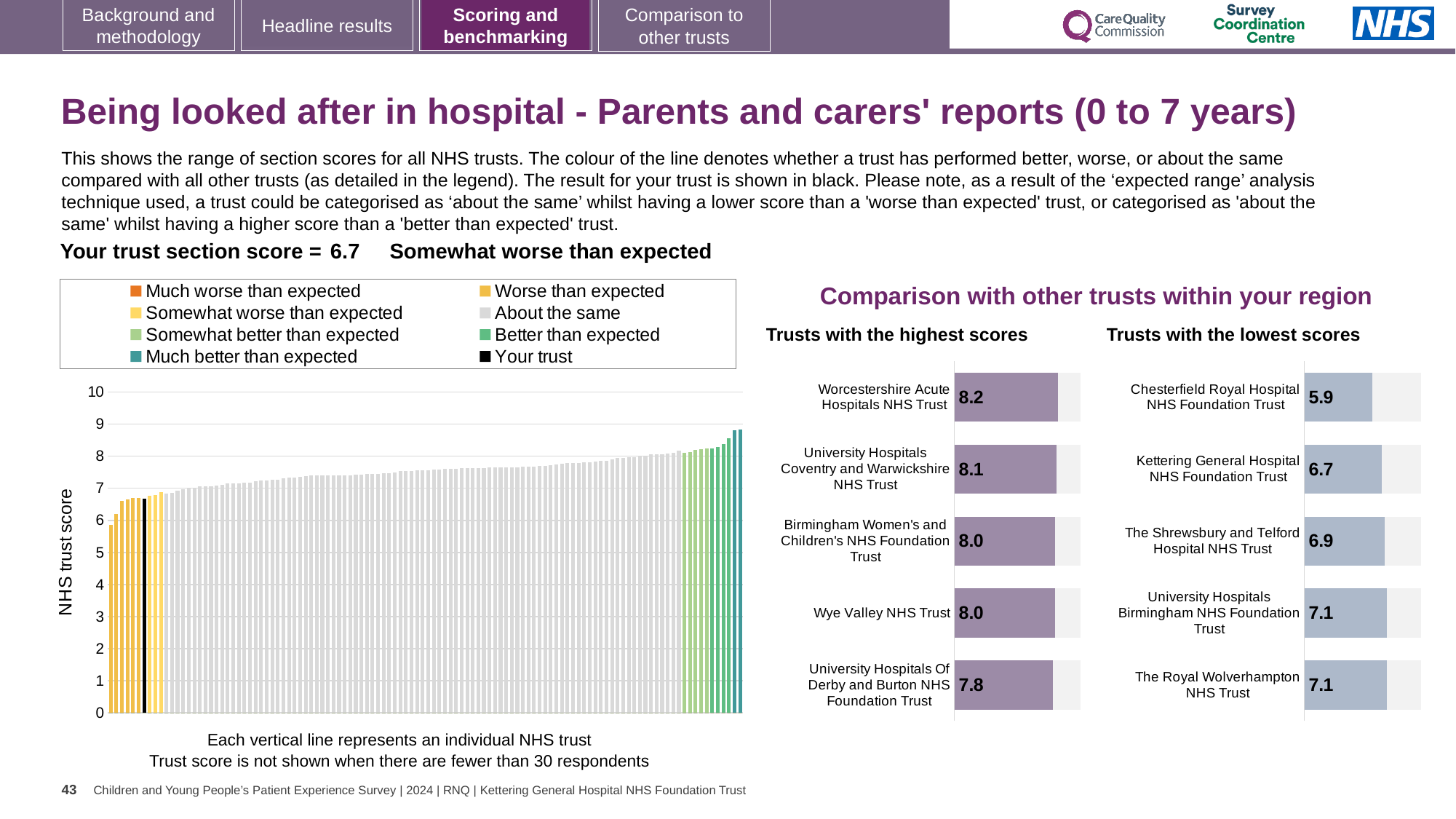
In the 'Trusts with the lowest scores' chart, what is the difference between the scores of Kettering General Hospital NHS Foundation Trust and Chesterfield Royal Hospital NHS Foundation Trust? 0.8 In the 'Trusts with the highest scores' chart, what is the difference between the scores of Worcestershire Acute Hospitals NHS Trust and University Hospitals Of Derby and Burton NHS Foundation Trust? 0.4 In the 'Trusts with the lowest scores' chart, which has the higher score: The Shrewsbury and Telford Hospital NHS Trust or Kettering General Hospital NHS Foundation Trust? The Shrewsbury and Telford Hospital NHS Trust What kind of chart is the large chart on the left with the 'NHS trust score' axis? Bar chart In the 'Trusts with the highest scores' chart, what is the score for Worcestershire Acute Hospitals NHS Trust? 8.2 In the large chart on the left, is the value for the black 'Your trust' bar greater or less than 7? less In the 'Trusts with the highest scores' chart, which trust has the lowest score shown? University Hospitals Of Derby and Burton NHS Foundation Trust In the 'Trusts with the lowest scores' chart, what is the score for Chesterfield Royal Hospital NHS Foundation Trust? 5.9 In the 'Trusts with the lowest scores' chart, which trust has the lowest score? Chesterfield Royal Hospital NHS Foundation Trust In the large chart on the left, do the trust scores rise or fall from left to right? Rise How many entries does the legend of the large chart on the left list? 8 In the 'Trusts with the highest scores' chart, how many trusts are shown? 5